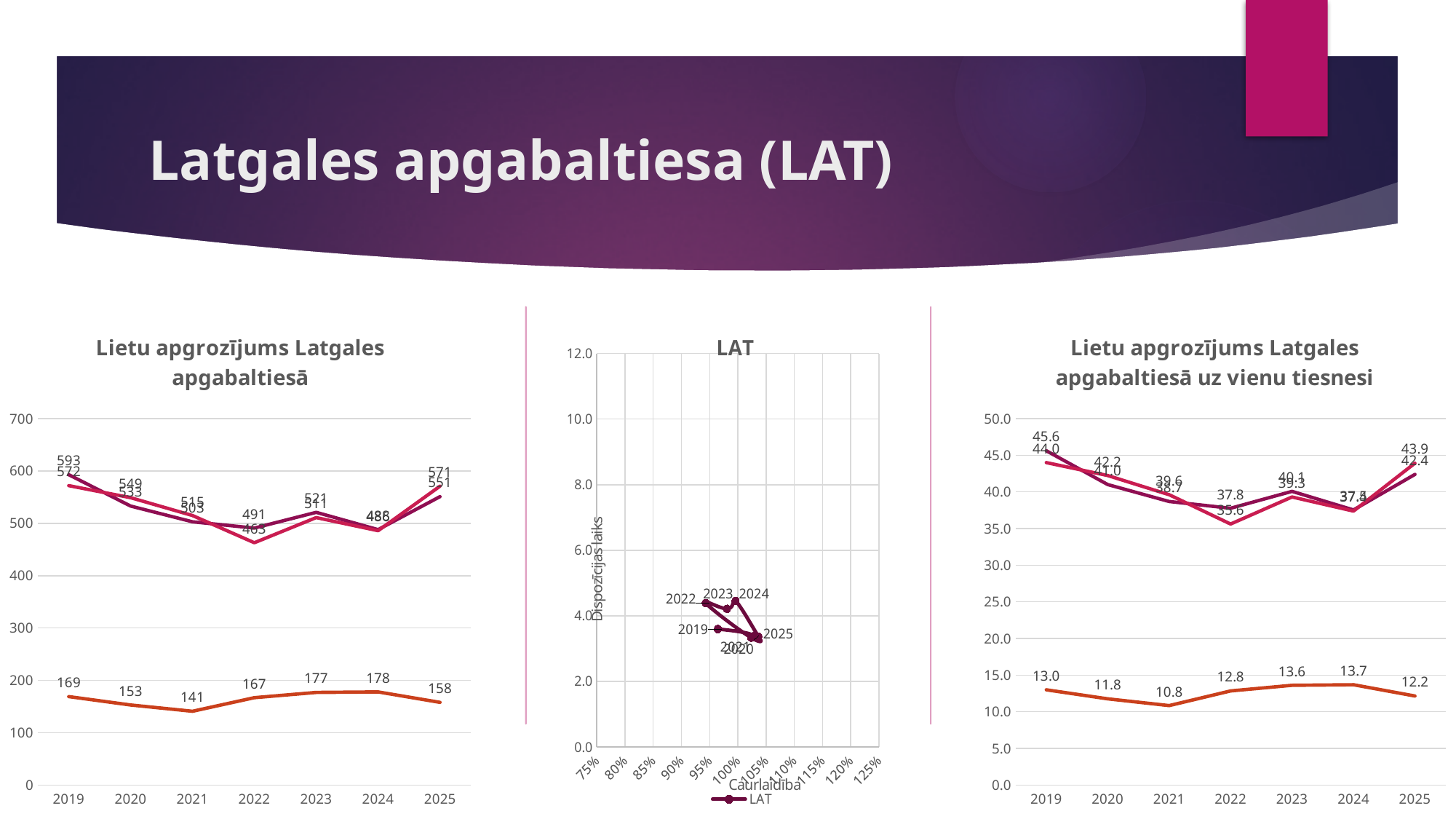
In the right chart 'Lietu apgrozījums Latgales apgabaltiesā uz vienu tiesnesi', what is the value of the orange line in 2021? 10.8 In the left chart 'Lietu apgrozījums Latgales apgabaltiesā', what is the highest value labelled on the chart? 593 In the middle chart 'LAT', what is the title of the x axis? Caurlaidība In the middle chart 'LAT', how many series does the legend list? 1 In the left chart 'Lietu apgrozījums Latgales apgabaltiesā', what is the difference between the orange line's values in 2019 and 2021? 28 In the middle chart 'LAT', is the Dispozīcijas laiks value for the 2025 point greater or less than 4.0? less In the left chart 'Lietu apgrozījums Latgales apgabaltiesā', what is the value of the lowest (orange) line in 2021? 141 In the right chart 'Lietu apgrozījums Latgales apgabaltiesā uz vienu tiesnesi', in which year is the orange line at its lowest? 2021 In the left chart 'Lietu apgrozījums Latgales apgabaltiesā', how many years are shown on the x axis? 7 In the right chart 'Lietu apgrozījums Latgales apgabaltiesā uz vienu tiesnesi', what is the difference between the orange line's values in 2024 and 2025? 1.5 What kind of chart is the left chart, 'Lietu apgrozījums Latgales apgabaltiesā'? line chart In the middle chart 'LAT', is the Caurlaidība value for the 2022 point greater or less than 100%? less